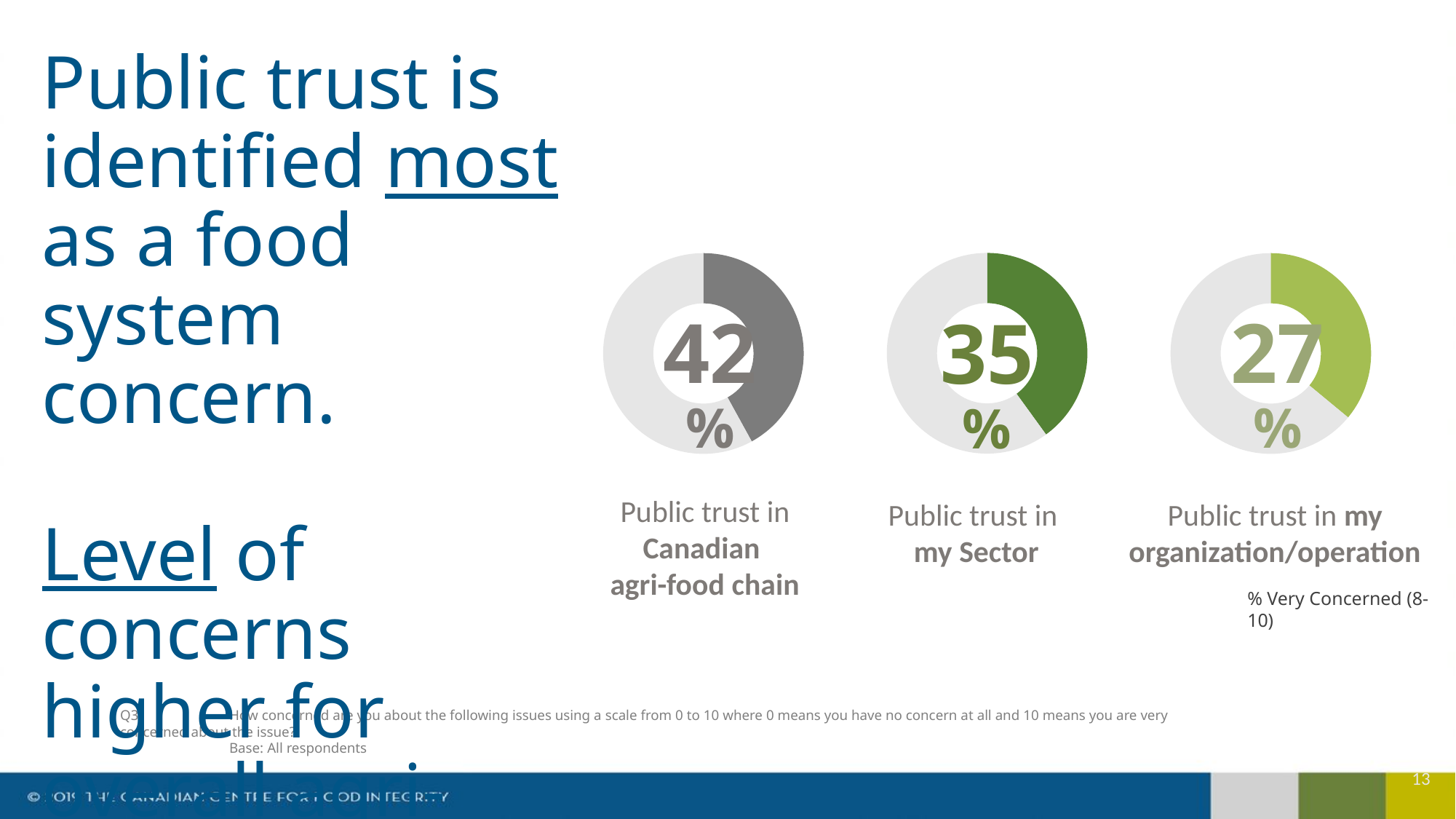
Which of the three donut charts shows the lowest percentage? Public trust in my organization/operation What percentage is shown in the donut chart for Public trust in my organization/operation? 27% How many donut charts are shown on the slide? 3 Which of the three donut charts shows the highest percentage? Public trust in Canadian agri-food chain What kind of chart is used to display the three percentages on the slide? Donut (pie) chart What is the difference in percentage points between the my Sector chart and the my organization/operation chart? 8 What percentage is shown in the donut chart for Public trust in my Sector? 35% Which is larger: the percentage for Public trust in my Sector or for Public trust in my organization/operation? Public trust in my Sector What percentage is shown in the donut chart for Public trust in Canadian agri-food chain? 42% What is the difference in percentage points between the Canadian agri-food chain chart and the my Sector chart? 7 What is the difference in percentage points between the Canadian agri-food chain chart and the my organization/operation chart? 15 According to the note beside the charts, what do the percentages represent? % Very Concerned (8-10)